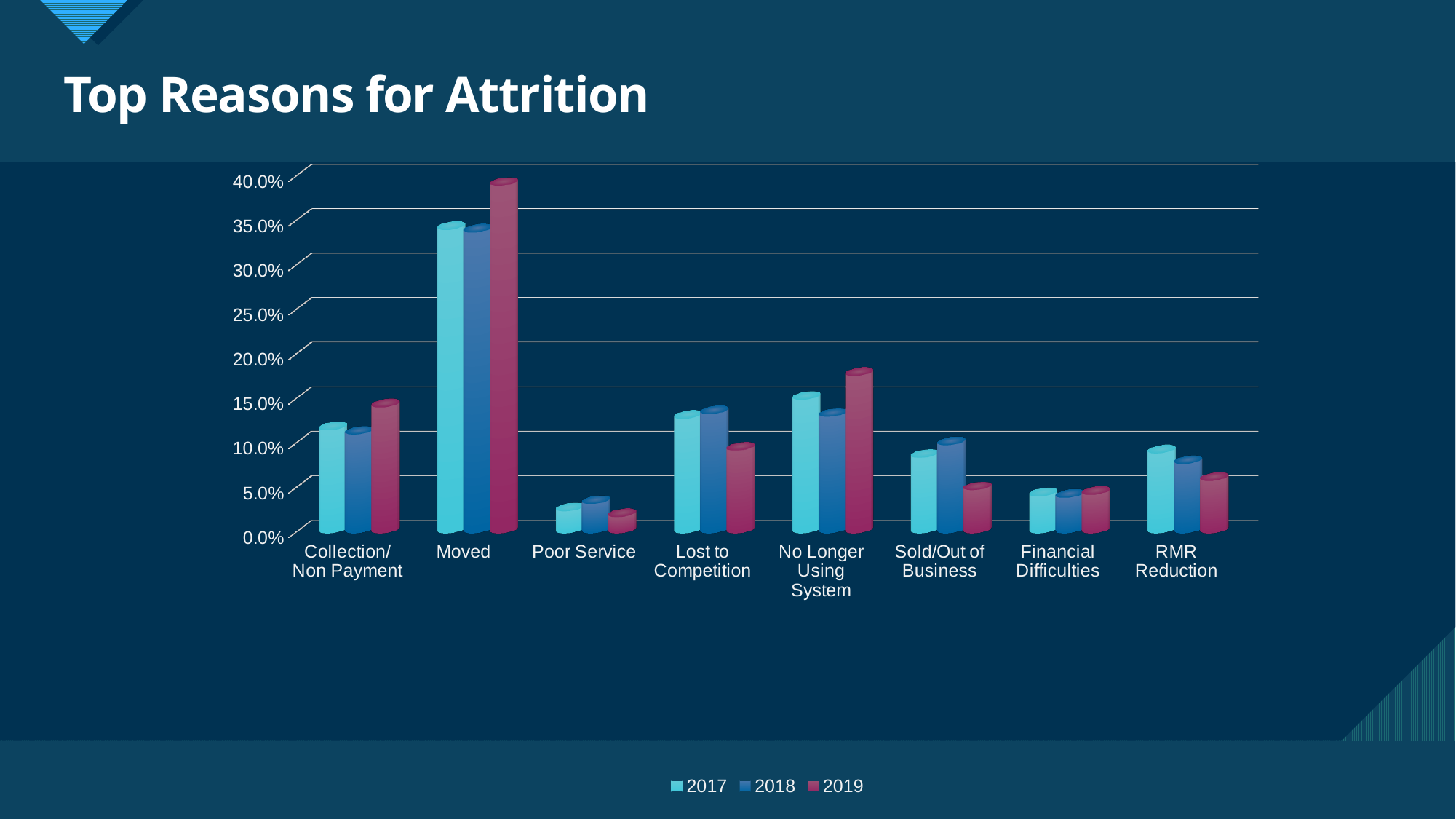
Is the 2019 value for Collection/Non Payment greater or less than 10.0%? greater For Sold/Out of Business, which year has the larger value: 2018 or 2019? 2018 What kind of chart is shown on the slide? bar chart Is the 2017 value for Moved greater or less than 30.0%? greater Which category has the highest value for 2019? Moved Which category has the highest value for 2017? Moved How many series does the legend list? 3 What are the entries listed in the legend? 2017, 2018, 2019 Which category has the lowest value for 2019? Poor Service Is the 2018 value for Poor Service greater or less than 5.0%? less How many attrition reason categories are shown on the x axis? 8 For 2019, which is larger: No Longer Using System or Lost to Competition? No Longer Using System